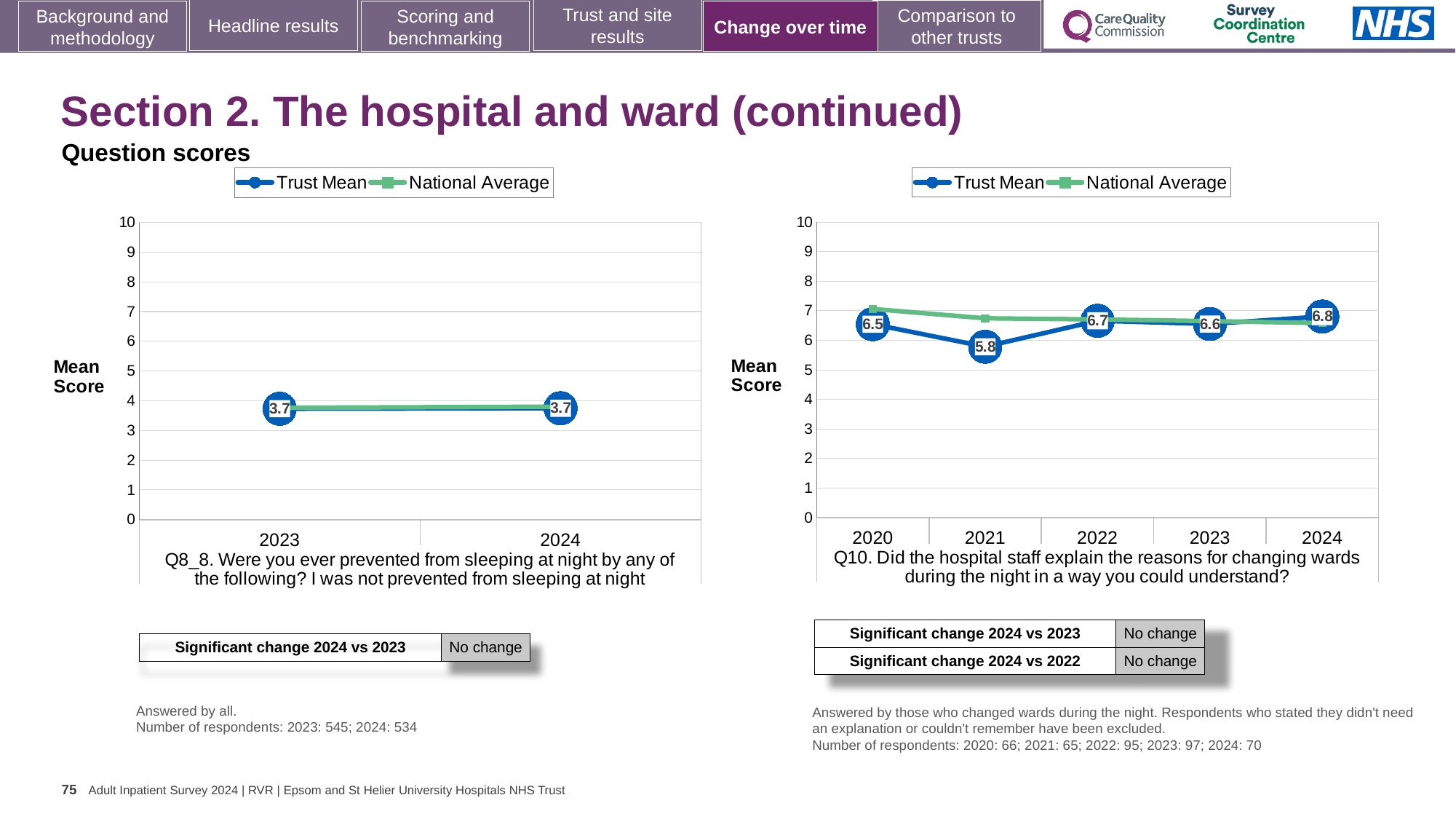
What kind of chart is the Q10 chart on the right? Line chart On the Q10 chart (right), which year has the highest Trust Mean? 2024 On the Q10 chart (right), what is the Trust Mean for 2024? 6.8 On the Q8_8 chart (left), is the Trust Mean for 2024 greater or less than 5? less On the Q10 chart (right), how many series does the legend list? 2 On the Q10 chart (right), which year has the lowest Trust Mean? 2021 On the Q10 chart (right), is the Trust Mean for 2022 larger or smaller than the Trust Mean for 2021? larger On the Q8_8 chart (left), what is the Trust Mean for 2023? 3.7 On the Q10 chart (right), what is the difference between the Trust Mean for 2024 and the Trust Mean for 2021? 1.0 On the Q10 chart (right), what is the Trust Mean for 2021? 5.8 On the Q8_8 chart (left), what is the Trust Mean for 2024? 3.7 On the Q8_8 chart (left), how many years are shown on the x axis? 2